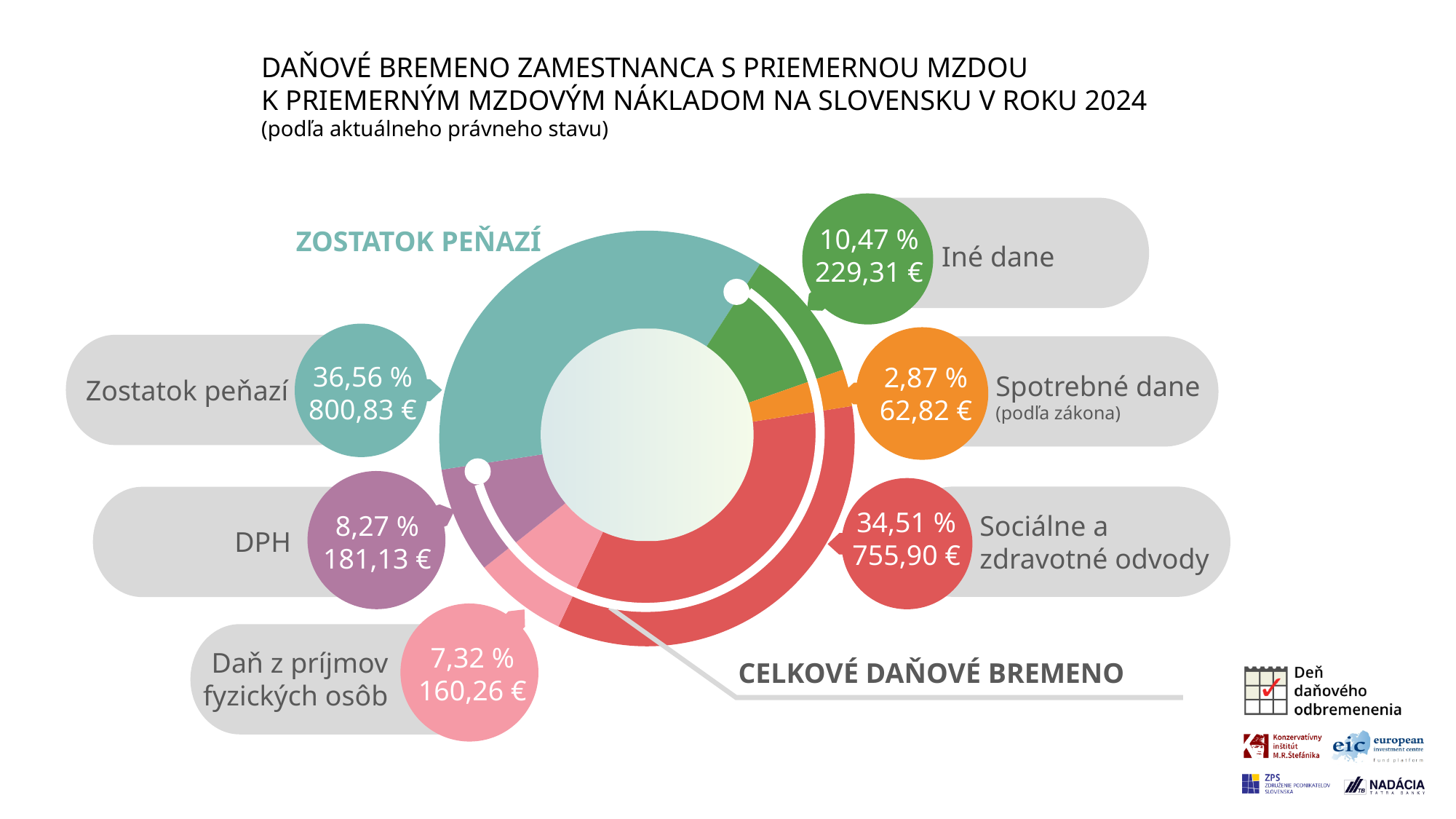
What percentage share is shown for Spotrebné dane? 2,87 % Which segment has the largest share of the donut chart? Zostatok peňazí What amount in euros is shown for Sociálne a zdravotné odvody? 755,90 € How many segments does the donut chart have? 6 What percentage share is shown for Zostatok peňazí? 36,56 % What amount in euros is shown for DPH? 181,13 € What is the difference in euros between Zostatok peňazí and Sociálne a zdravotné odvody? 44,93 € What is the difference in euros between Iné dane and Daň z príjmov fyzických osôb? 69,05 € Which is larger in euros: Iné dane or DPH? Iné dane What label is given to the part of the donut chart that excludes Zostatok peňazí? CELKOVÉ DAŇOVÉ BREMENO Which segment has the smallest share of the donut chart? Spotrebné dane What type of chart is shown on the slide? Pie (donut) chart